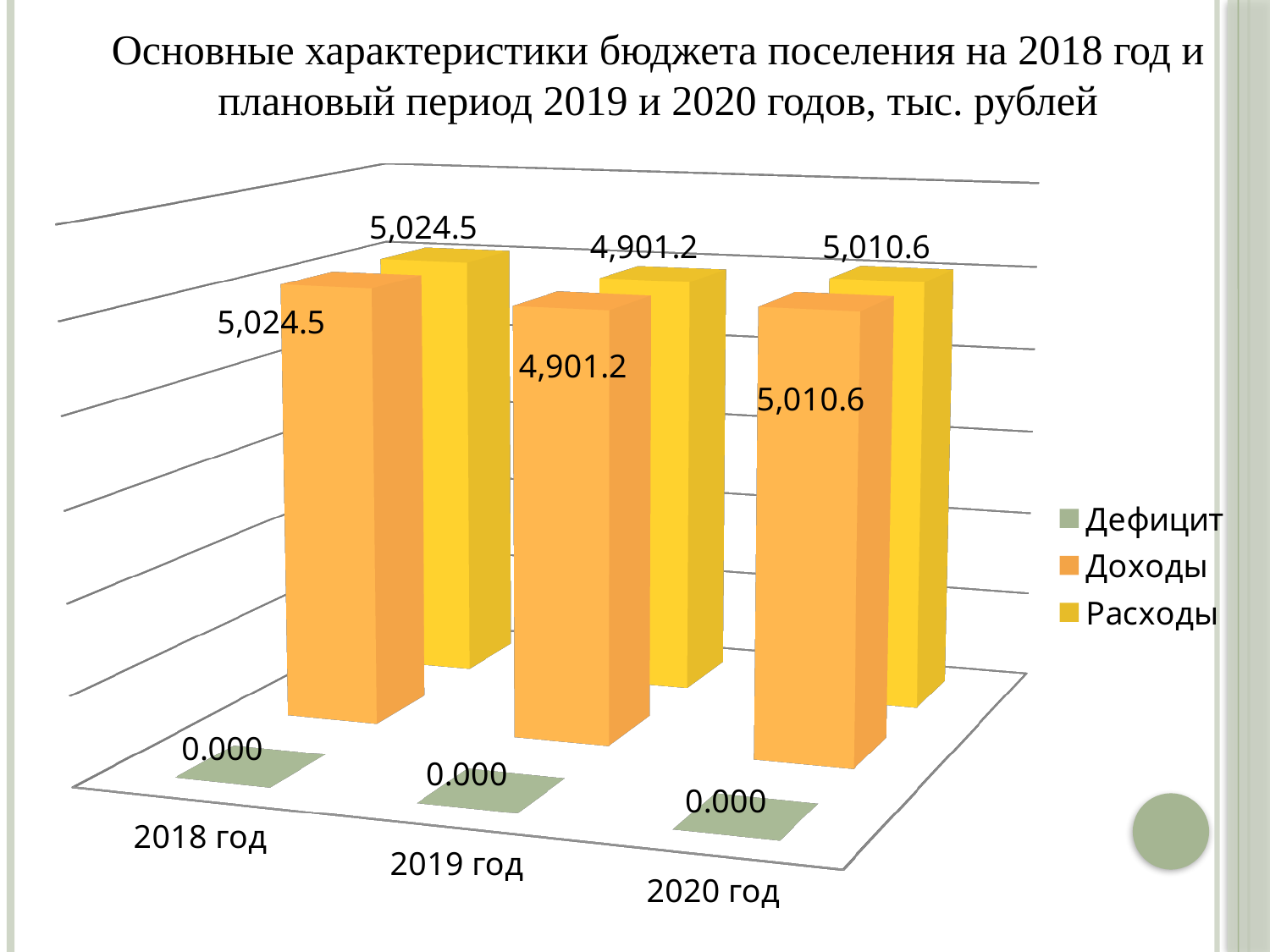
What kind of chart is shown on the slide? Bar chart Which is larger: Расходы for 2020 год or Расходы for 2019 год? Расходы for 2020 год What is the value of Доходы for 2018 год? 5,024.5 What is the value of Доходы for 2020 год? 5,010.6 How many series does the legend list? 3 Which series is shown in green in the legend? Дефицит Which year has the lowest value for Доходы? 2019 год What is the value of Дефицит for 2019 год? 0.000 How many years are shown on the x axis? 3 Which year has the highest value for Расходы? 2018 год What is the difference between Доходы for 2018 год and Доходы for 2019 год? 123.3 What is the value of Расходы for 2019 год? 4,901.2